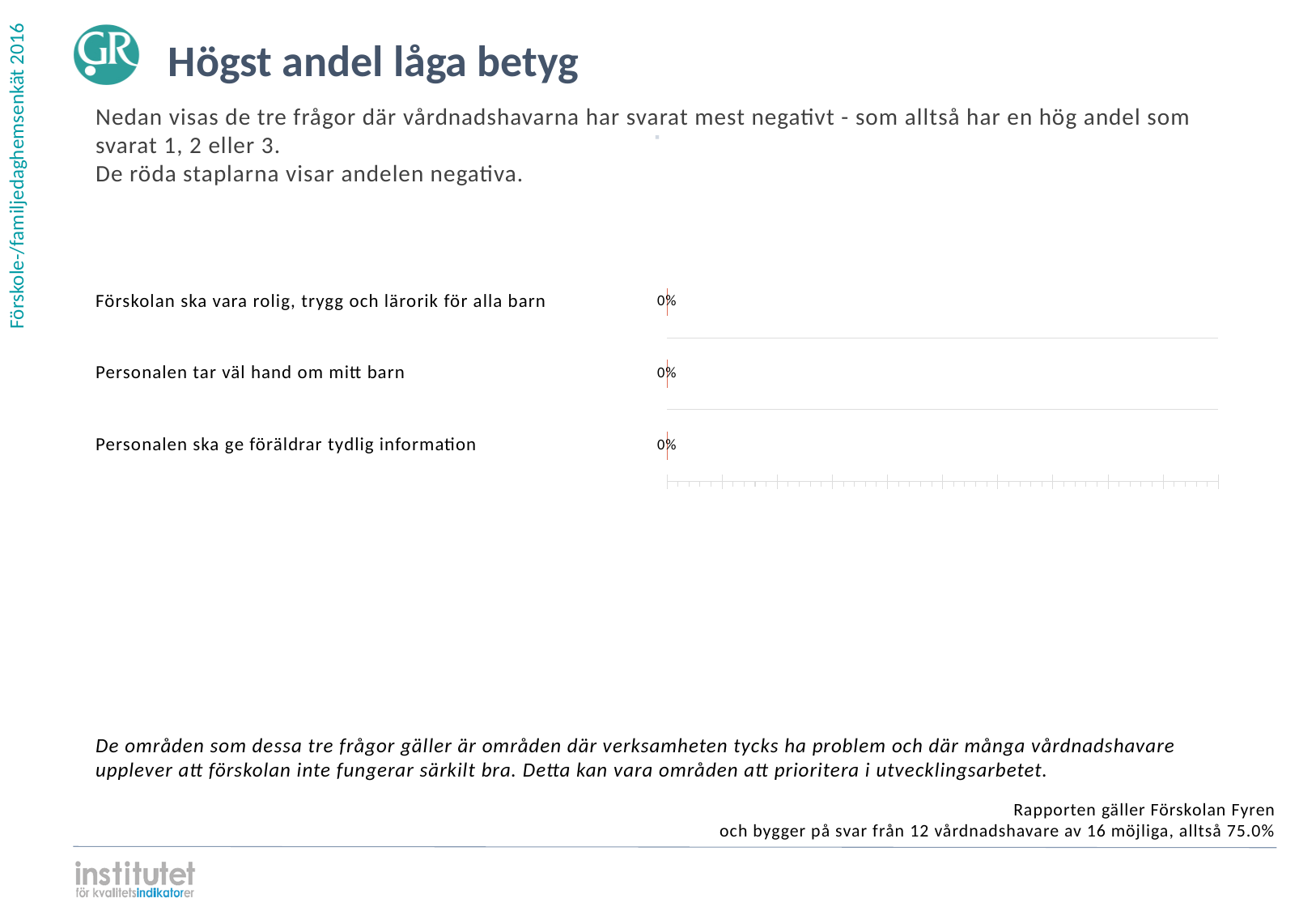
What is the title of the slide containing the chart? Högst andel låga betyg How many categories (questions) are plotted in the chart? 3 What is the difference between the value for "Personalen tar väl hand om mitt barn" and the value for "Personalen ska ge föräldrar tydlig information"? 0% What value is shown for "Personalen tar väl hand om mitt barn"? 0% What value is shown for "Förskolan ska vara rolig, trygg och lärorik för alla barn"? 0% According to the slide text, what colour are the bars that show the share of negative answers? Red What value is shown for "Personalen ska ge föräldrar tydlig information"? 0% What kind of chart is shown on the slide? Bar chart Do all three categories in the chart show the same value? Yes